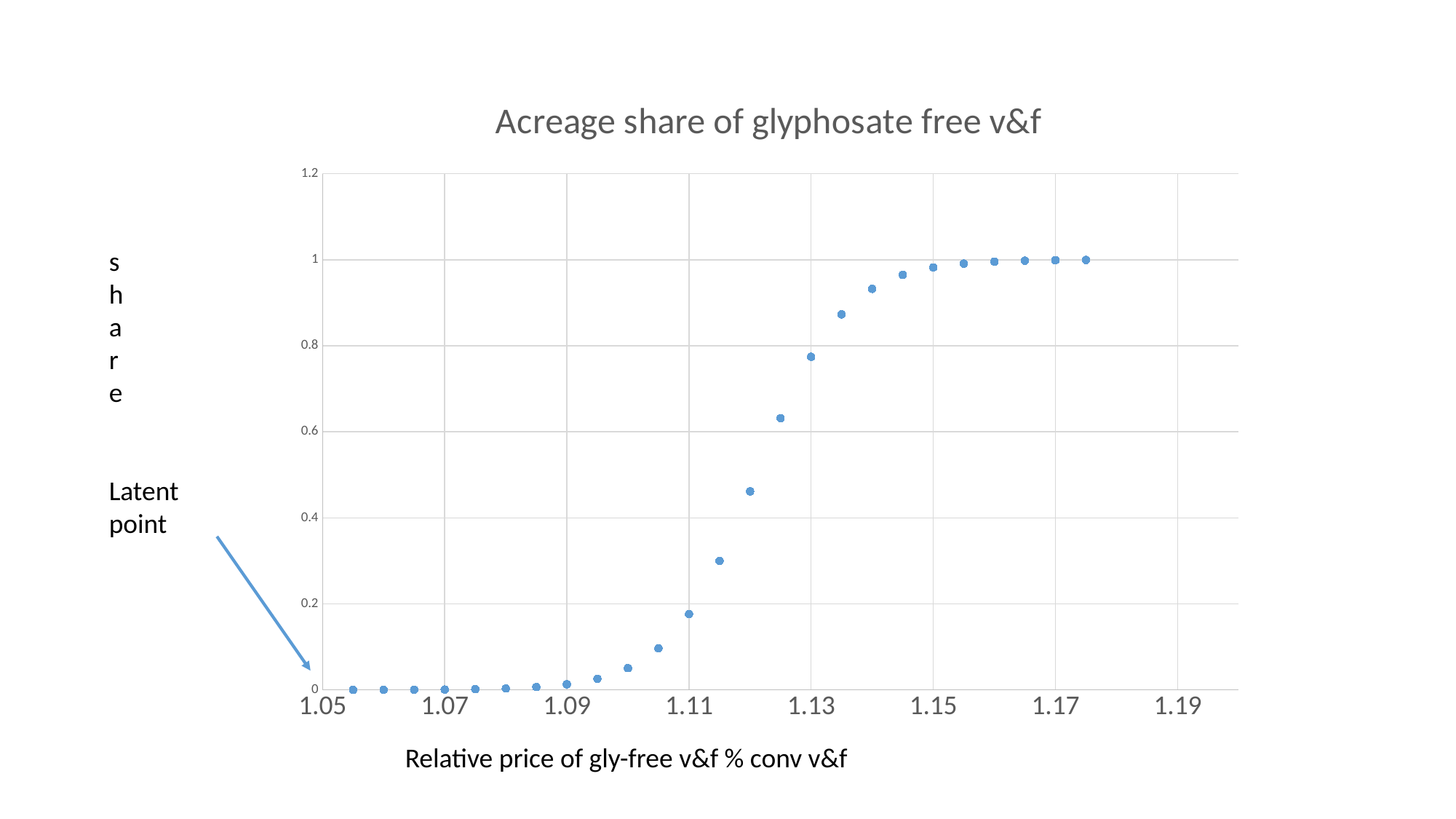
Is the value at a relative price of 1.12 greater or less than 0.4? greater What kind of chart is shown on the slide? scatter chart Is the value at a relative price of 1.13 greater or less than 0.8? less What is the label of the x axis? Relative price of gly-free v&f % conv v&f Which has the larger value: the point at 1.13 or the point at 1.115? 1.13 Which has the larger value: the point at 1.11 or the point at 1.12? 1.12 Is the value at a relative price of 1.115 greater or less than 0.2? greater What is the title of the chart? Acreage share of glyphosate free v&f How many data points are plotted on the chart? 25 Do the plotted values rise or fall as the relative price increases along the x axis? rise